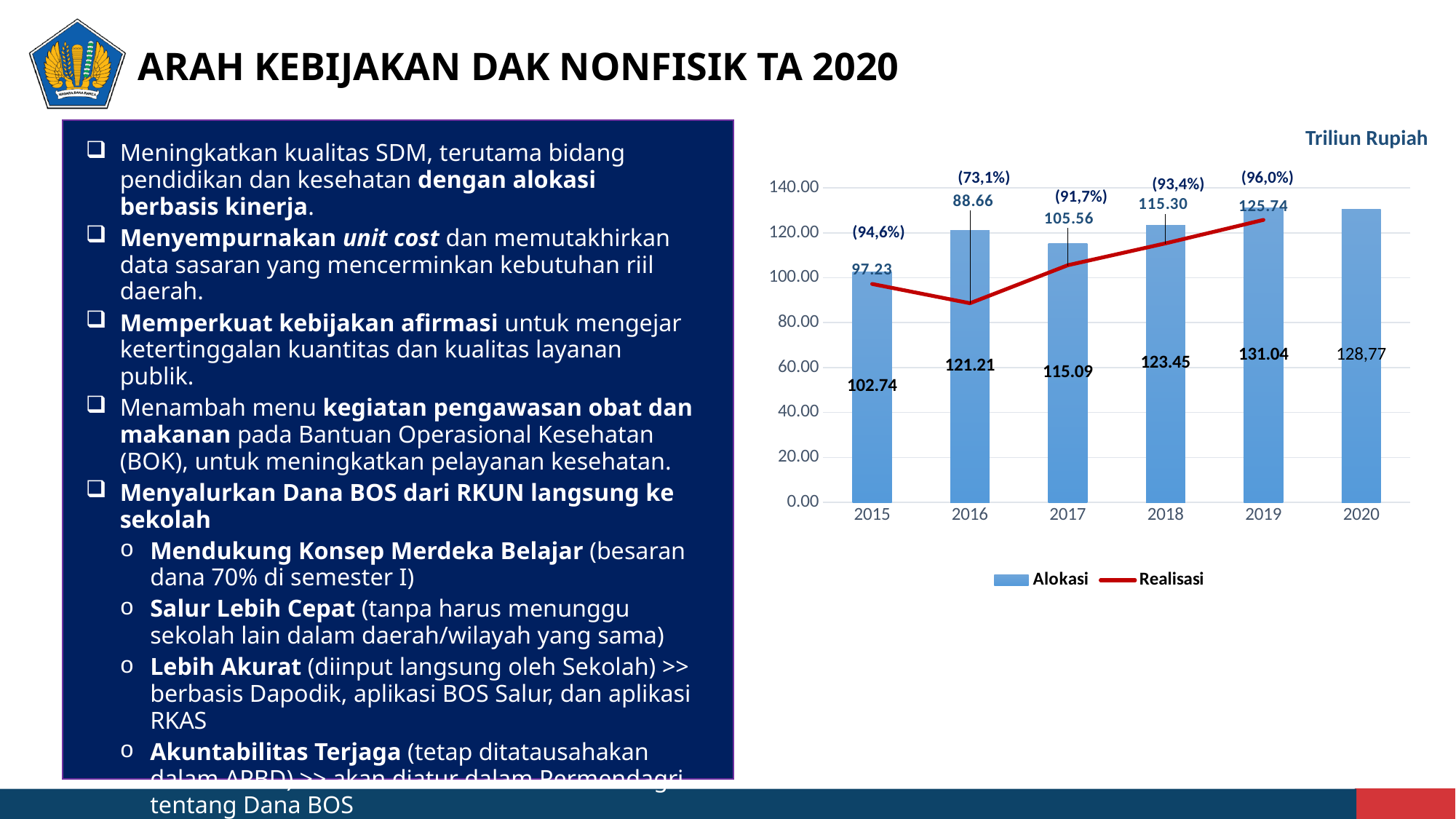
Which is larger, the Alokasi value for 2016 or the Alokasi value for 2017? 2016 Which year has the lowest Realisasi value? 2016 What is the Realisasi value for 2019? 125.74 What unit is stated in the top-right corner of the chart? Triliun Rupiah What is the difference between the Alokasi and Realisasi values for 2018? 8.15 What kind of chart is used to show the Alokasi series? bar chart How many series does the legend list? 2 What is the Alokasi value for 2017? 115.09 What is the Alokasi value for 2020? 128,77 What is the Realisasi value for 2016? 88.66 How many years are shown on the x axis? 6 Which year has the highest Alokasi value? 2019